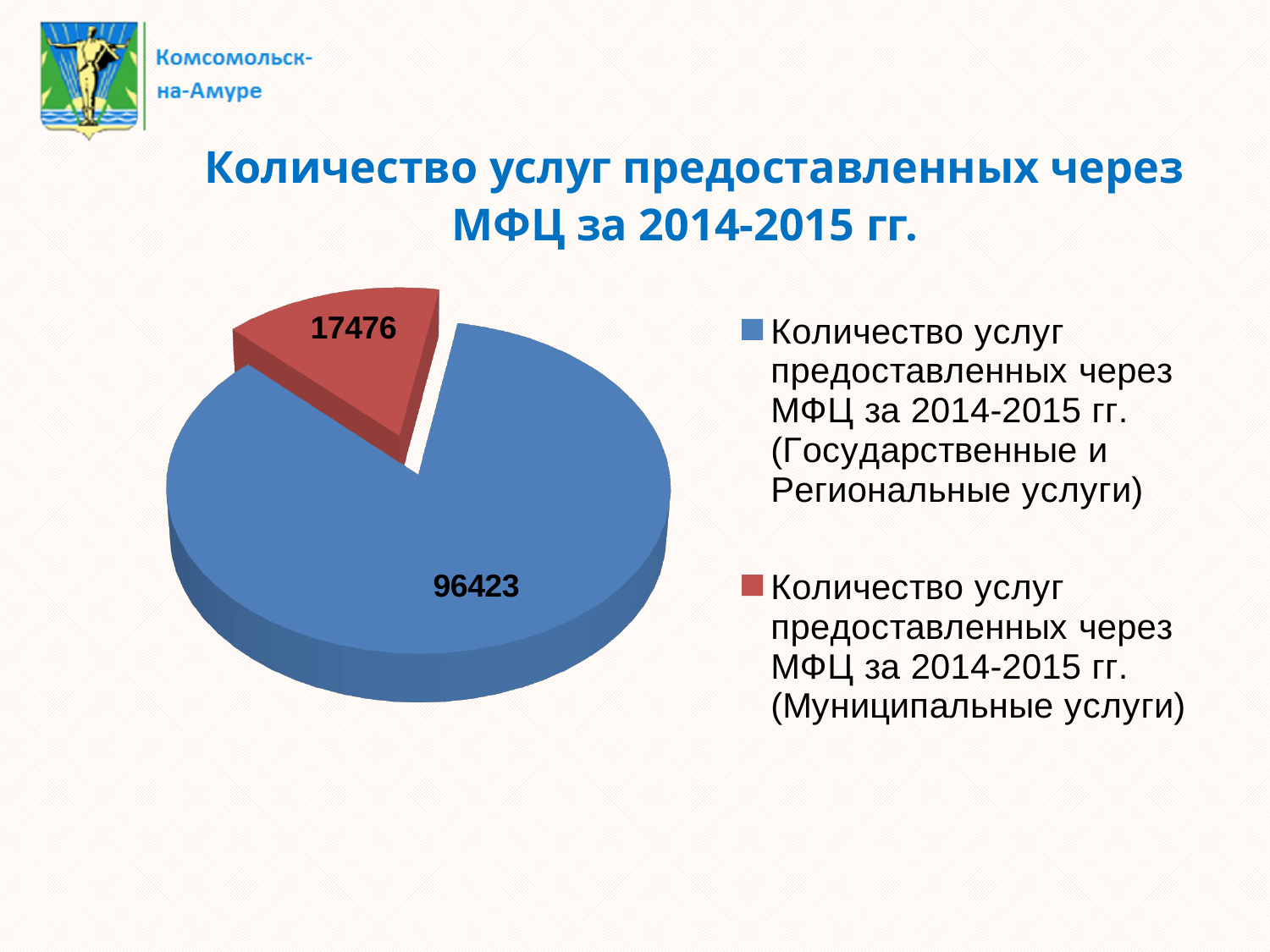
Which is larger: the value for state and regional services or the value for municipal services? State and regional services (96423) What is the value for state and regional services (Государственные и Региональные услуги)? 96423 What colour is the slice for municipal services? Red What kind of chart is shown on the slide? Pie chart How many slices does the pie chart have? 2 What is the value for municipal services (Муниципальные услуги)? 17476 Which slice is the smallest? Муниципальные услуги What is the total of the two slices in the pie chart? 113899 How many entries does the legend list? 2 Which slice is the largest? Государственные и Региональные услуги What is the difference between the value for state and regional services and the value for municipal services? 78947